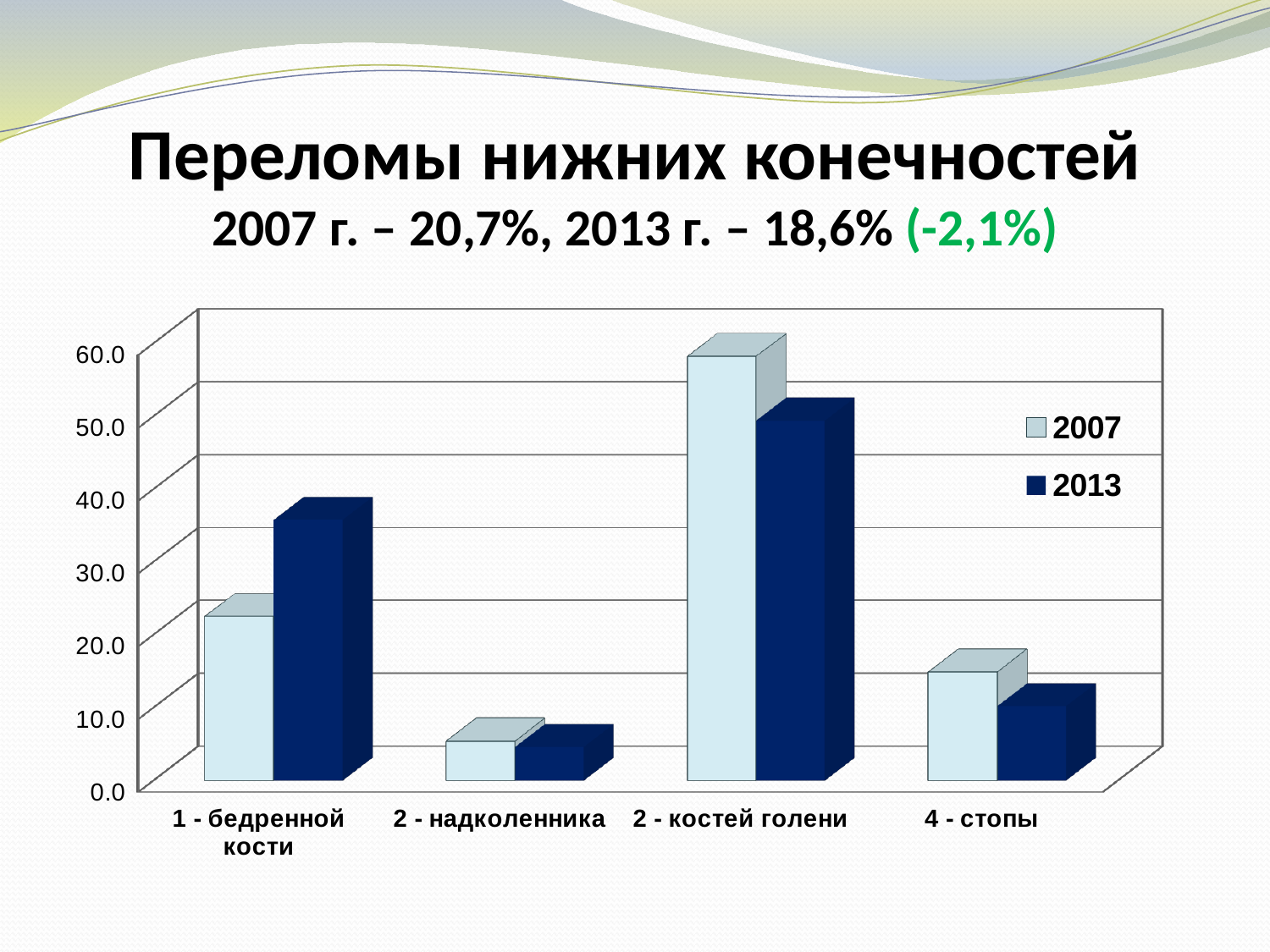
Which category has the lowest value for 2013? 2 - надколенника Which category has the highest value for 2007? 2 - костей голени What are the two series named in the legend? 2007 and 2013 What kind of chart is shown on the slide? bar chart How many categories are shown on the x axis? 4 How many series does the legend list? 2 Is the 2013 value for 1 - бедренной кости greater or less than 30.0? greater For 2 - костей голени, which series has the larger value, 2007 or 2013? 2007 Which category has the lowest value for 2007? 2 - надколенника Is the 2007 value for 2 - костей голени greater or less than 50.0? greater Is the 2007 value for 4 - стопы greater or less than 20.0? less For 1 - бедренной кости, which series has the larger value, 2007 or 2013? 2013